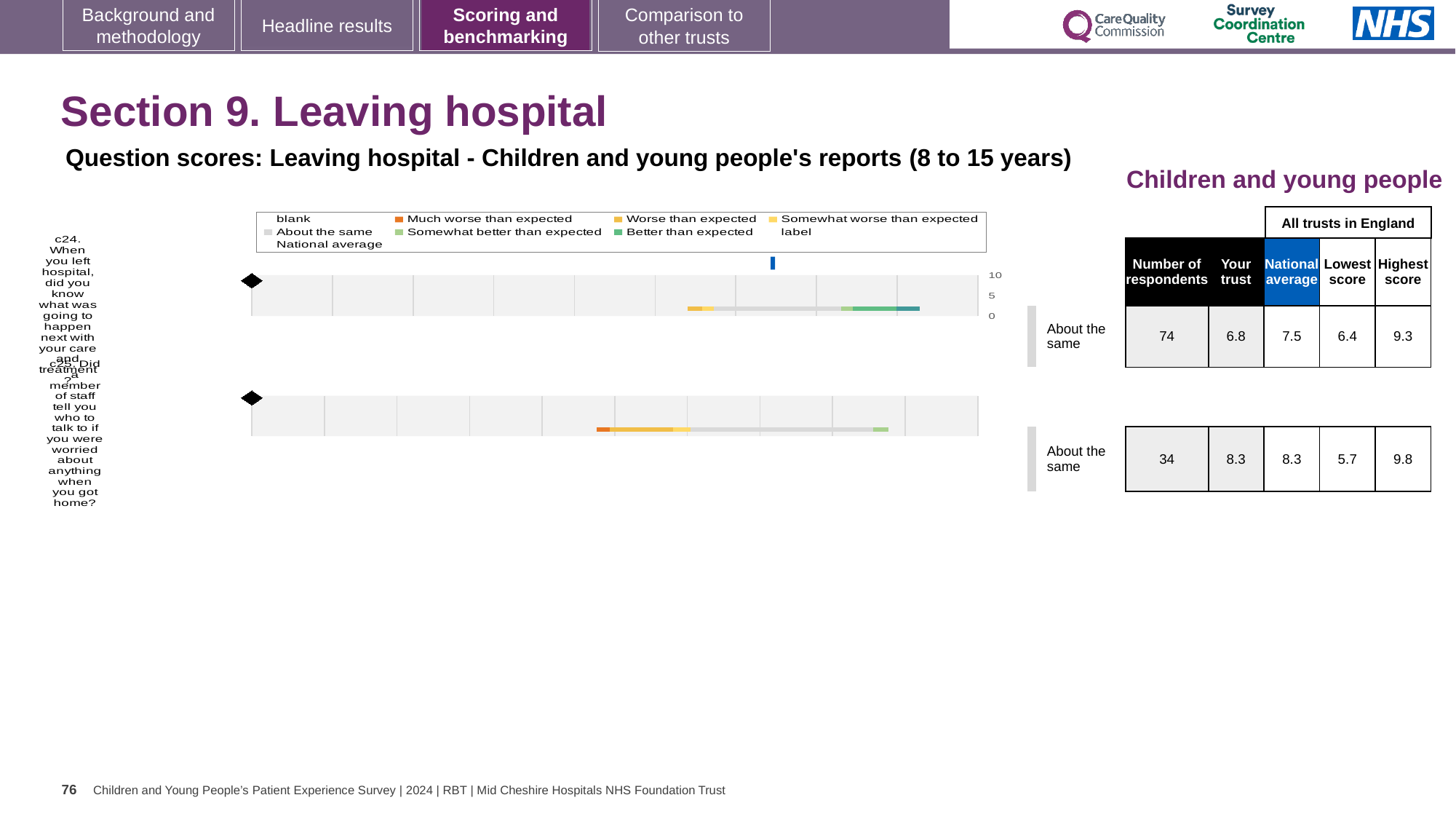
What is the lowest score among all trusts in England for question c24? 6.4 What is the difference between the highest and lowest trust scores for question c24? 2.9 Is the trust's score for question c25 greater or less than 5? greater What benchmark category is shown for question c24 in the chart? About the same How many respondents answered question c25 (Did a member of staff tell you who to talk to if you were worried about anything when you got home?)? 34 What kind of chart is used to show the question scores on this slide? bar chart What is the highest score among all trusts in England for question c25? 9.8 For question c24, which is higher: the trust's score or the national average? National average What is the 'Your trust' score for question c24 (When you left hospital, did you know what was going to happen next with your care and treatment?)? 6.8 What is the difference between the highest and lowest trust scores for question c25? 4.1 What is the national average score for question c24? 7.5 How many survey questions are plotted in the chart? 2